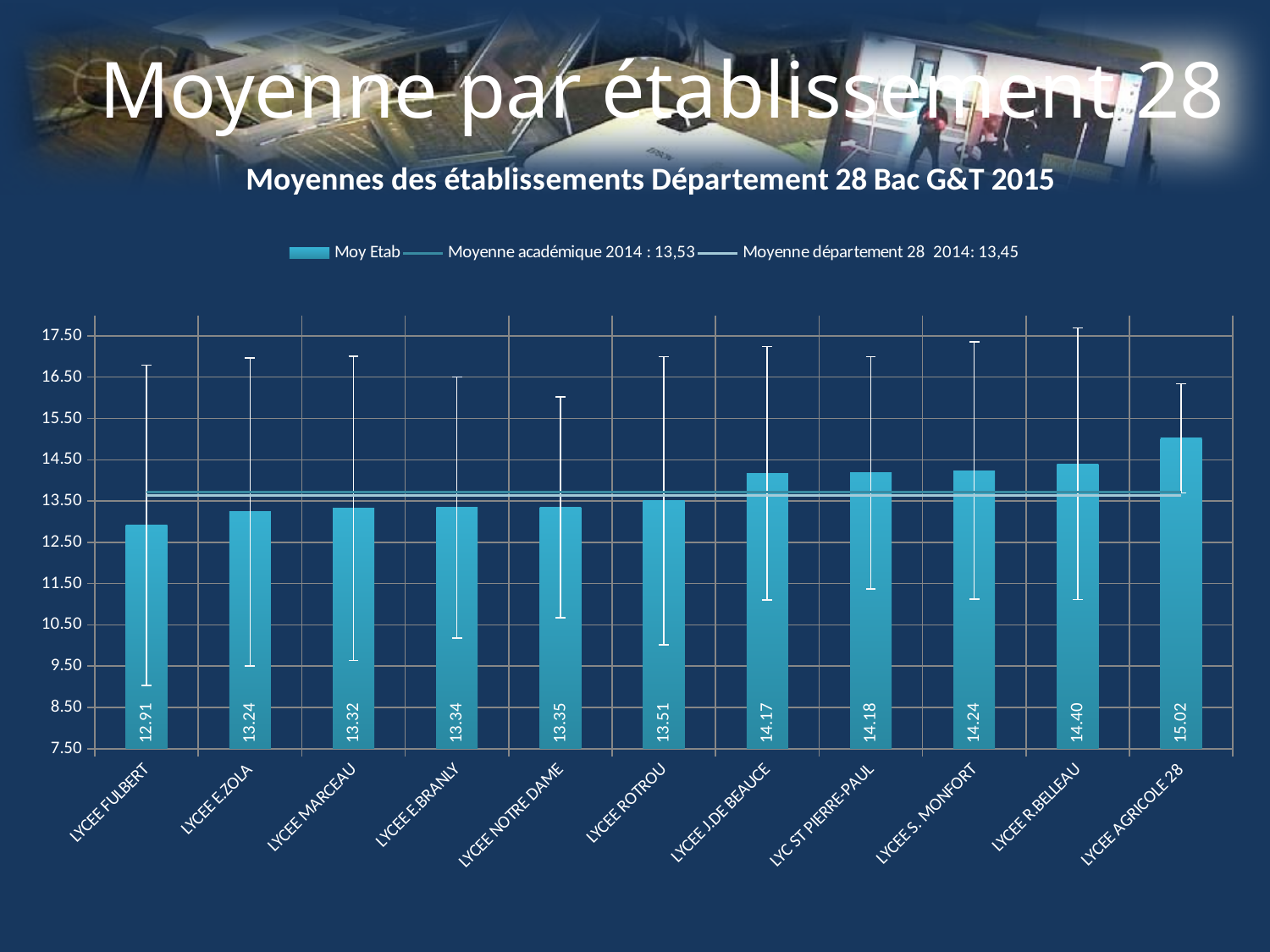
What is the difference between the values for LYCEE AGRICOLE 28 and LYCEE FULBERT? 2.11 How many series does the legend list? 3 What is the title of the chart? Moyennes des établissements Département 28 Bac G&T 2015 Which establishment has the lowest value? LYCEE FULBERT How many establishments are shown on the x axis? 11 Which is larger, the value for LYCEE ROTROU or the value for LYCEE S. MONFORT? LYCEE S. MONFORT What is the value for LYCEE J.DE BEAUCE? 14.17 Is the value for LYCEE E.ZOLA greater or less than 13.50? less What is the value for LYCEE R.BELLEAU? 14.40 What is the value for LYCEE FULBERT? 12.91 What kind of chart is this? combination bar and line chart Which establishment has the highest value? LYCEE AGRICOLE 28